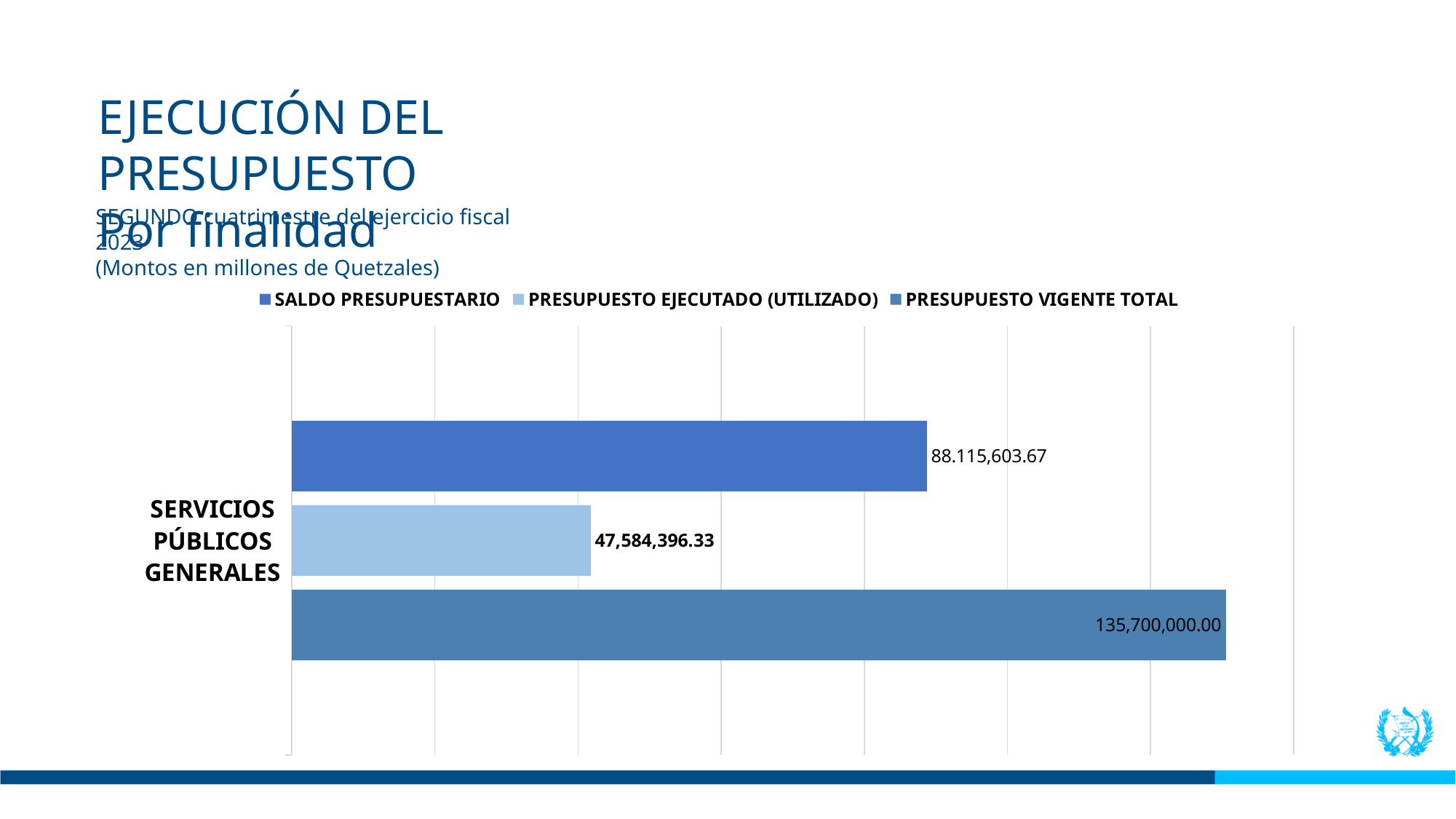
What is the value of PRESUPUESTO VIGENTE TOTAL for SERVICIOS PÚBLICOS GENERALES? 135,700,000.00 Which legend entry is shown in the lightest blue colour? PRESUPUESTO EJECUTADO (UTILIZADO) What kind of chart is shown on the slide? bar chart What is the difference between PRESUPUESTO VIGENTE TOTAL and PRESUPUESTO EJECUTADO (UTILIZADO) for SERVICIOS PÚBLICOS GENERALES? 88,115,603.67 Which series has the lowest value for SERVICIOS PÚBLICOS GENERALES? PRESUPUESTO EJECUTADO (UTILIZADO) What is the name of the only category shown on the chart? SERVICIOS PÚBLICOS GENERALES How many series does the legend list? 3 How many categories are shown on the chart? 1 Which series has the highest value for SERVICIOS PÚBLICOS GENERALES? PRESUPUESTO VIGENTE TOTAL Which is larger for SERVICIOS PÚBLICOS GENERALES: SALDO PRESUPUESTARIO or PRESUPUESTO EJECUTADO (UTILIZADO)? SALDO PRESUPUESTARIO What is the value of PRESUPUESTO EJECUTADO (UTILIZADO) for SERVICIOS PÚBLICOS GENERALES? 47,584,396.33 What is the value of SALDO PRESUPUESTARIO for SERVICIOS PÚBLICOS GENERALES? 88.115,603.67